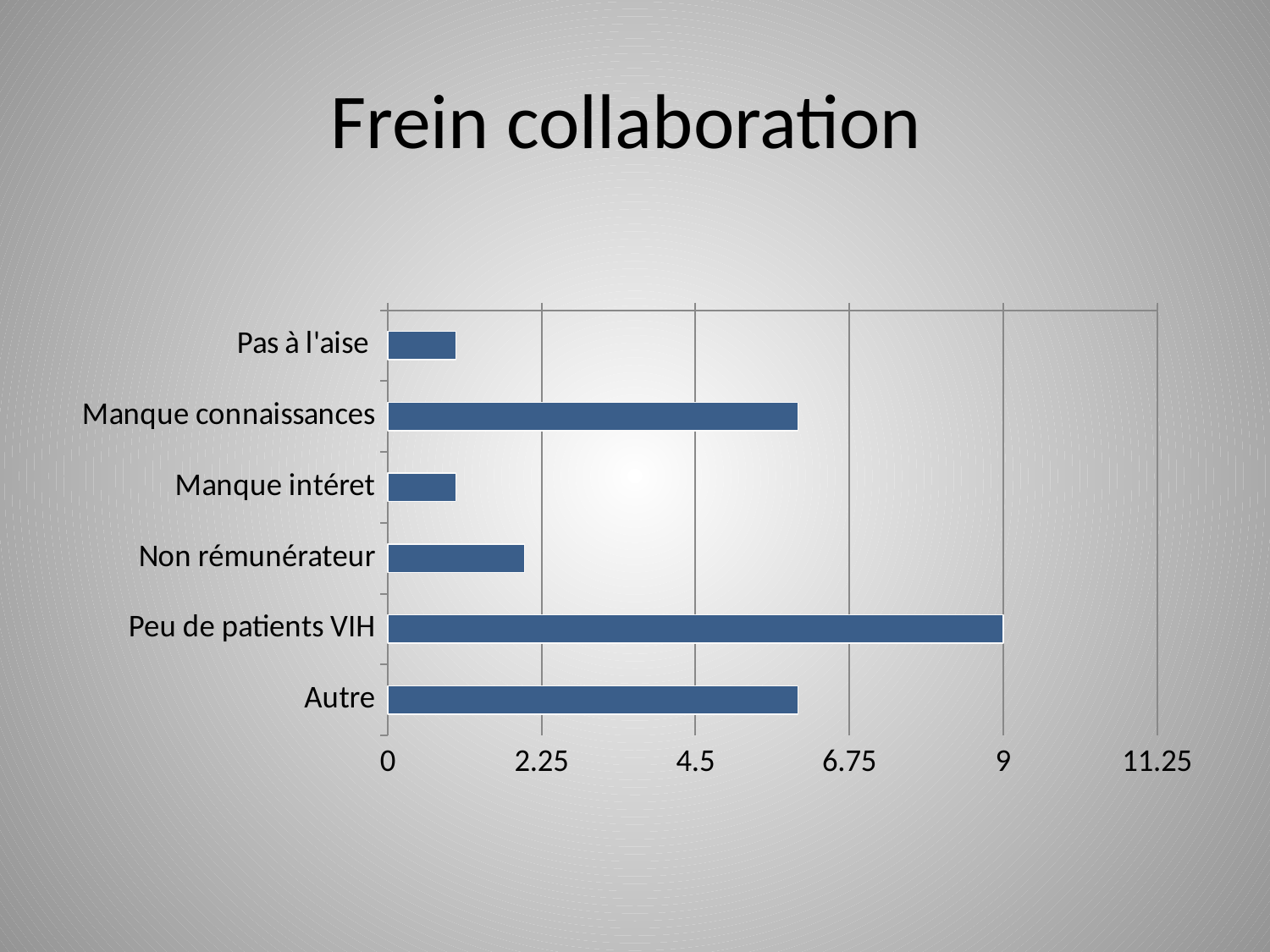
Is the value for Pas à l'aise greater or less than 2.25? less How many categories are shown in the chart? 6 Which is larger, the value for Peu de patients VIH or the value for Manque connaissances? Peu de patients VIH Is the value for Non rémunérateur greater or less than 2.25? less Which is larger, the value for Non rémunérateur or the value for Manque intéret? Non rémunérateur Is the value for Manque connaissances greater or less than 4.5? greater What kind of chart is shown on the slide? bar chart Which category has the highest value? Peu de patients VIH What is the value for Peu de patients VIH? 9 What is the title of the chart? Frein collaboration